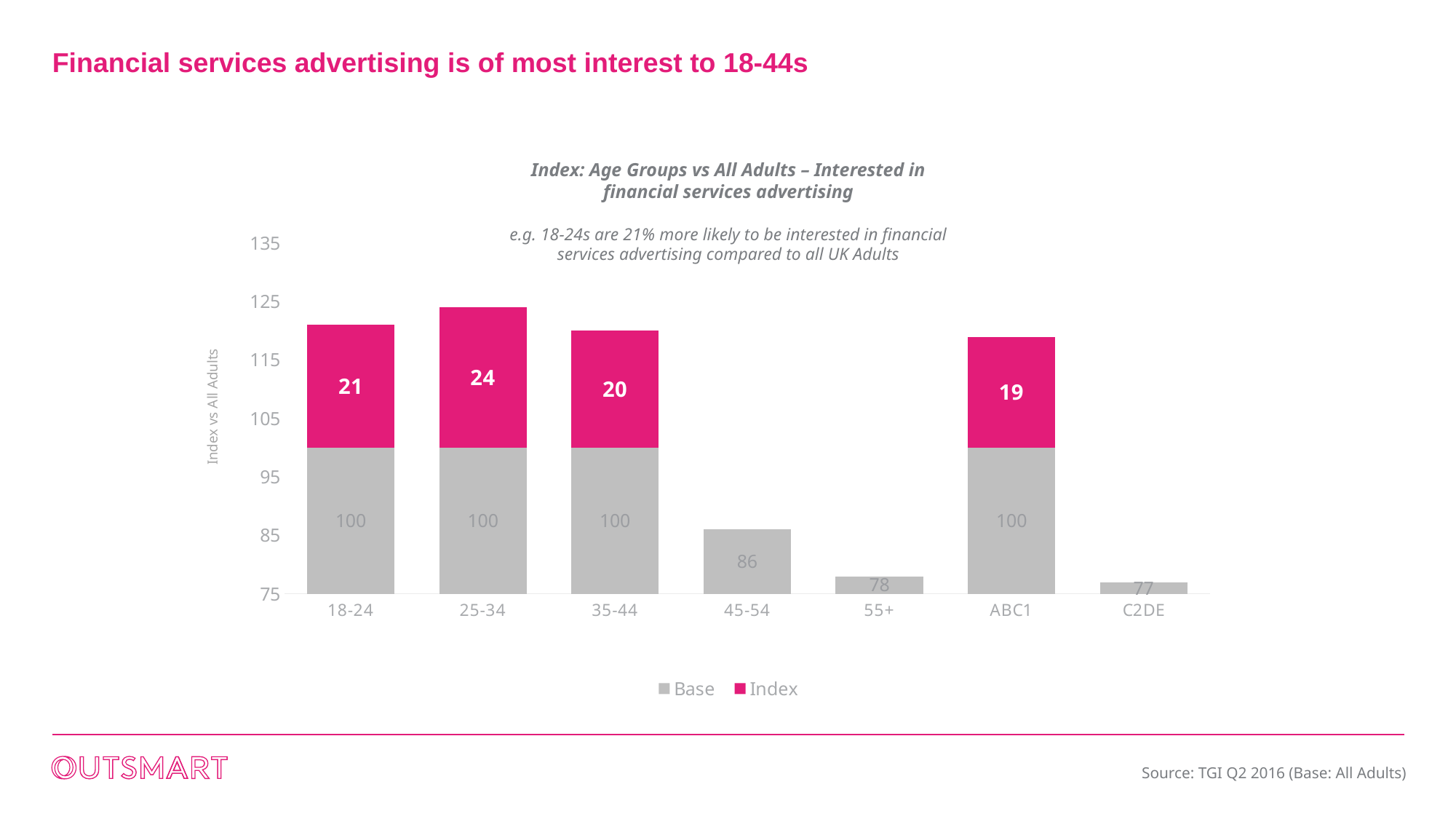
How many series does the legend list? 2 What is the Index value for the 25-34 age group? 24 How many categories are shown on the x axis? 7 What is the Index value for ABC1? 19 Which category has the highest Index value? 25-34 What is the total height of the stacked bar for 35-44 (Base plus Index)? 120 What is the Base value for C2DE? 77 Which category has the lowest Base value? C2DE What type of chart is shown on the slide? Stacked bar chart What is the Base value for the 45-54 age group? 86 Which has a larger Base value, 45-54 or 55+? 45-54 What is the difference between the Index values for 25-34 and 18-24? 3